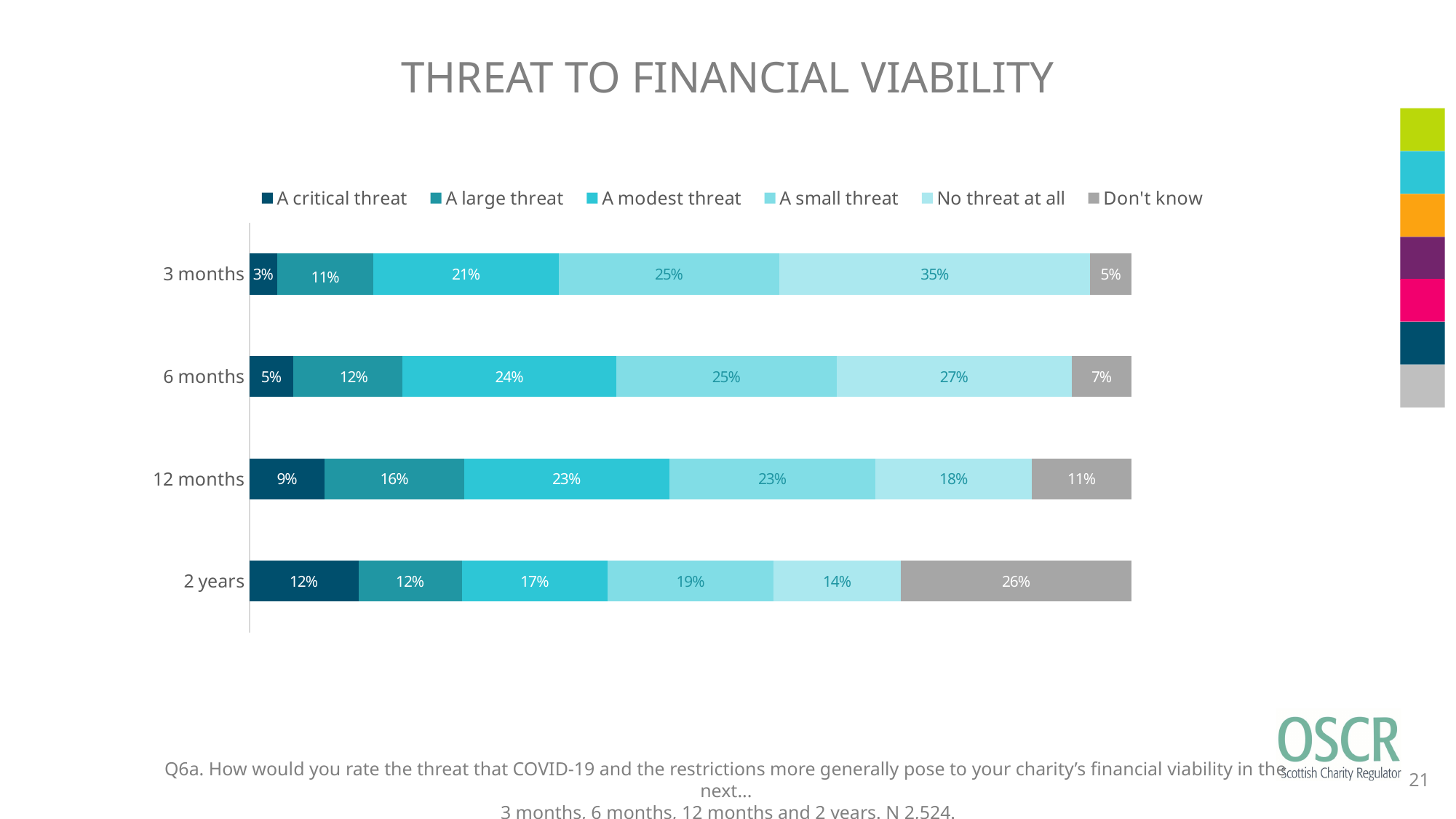
What is the total of the 3 months stacked bar? 100% What is the value for 'A critical threat' in the 12 months bar? 9% What is the 'Don't know' value for the 2 years bar? 26% Which has the larger 'A large threat' value, 6 months or 12 months? 12 months Which time period has the lowest value for 'No threat at all'? 2 years Which time period has the highest value for 'A critical threat'? 2 years Does the 'A critical threat' value rise or fall as the time period increases from 3 months to 2 years? Rises What kind of chart is shown on the slide? Stacked bar chart What is the difference between the 'A modest threat' values for 6 months and 2 years? 7 percentage points How many time periods are shown on the chart? 4 What percentage of charities said COVID-19 posed no threat at all to their financial viability in the next 3 months? 35% How many series does the legend list? 6